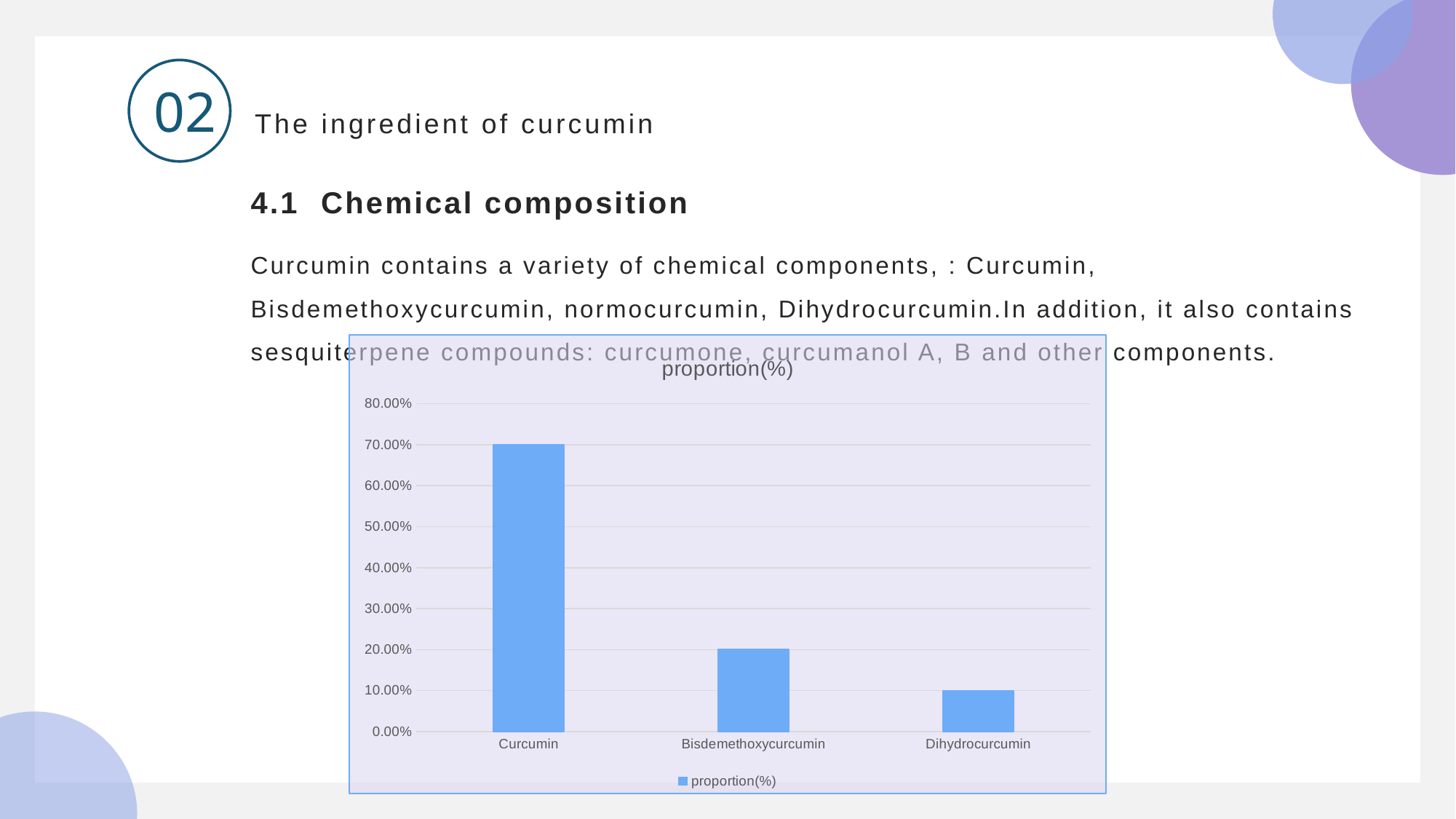
What is the title of the chart? proportion(%) How many series does the chart legend list? 1 Which category has the highest proportion? Curcumin What kind of chart is shown on the slide? bar chart Which category has the lowest proportion? Dihydrocurcumin Is the value for Curcumin greater or less than 60.00%? greater How many categories are shown on the x axis of the chart? 3 Which is larger, the value for Bisdemethoxycurcumin or the value for Dihydrocurcumin? Bisdemethoxycurcumin What is the name of the series shown in the legend? proportion(%) Is the value for Bisdemethoxycurcumin greater or less than 30.00%? less Is the value for Dihydrocurcumin greater or less than 20.00%? less Do the values rise or fall moving left to right along the x axis? fall